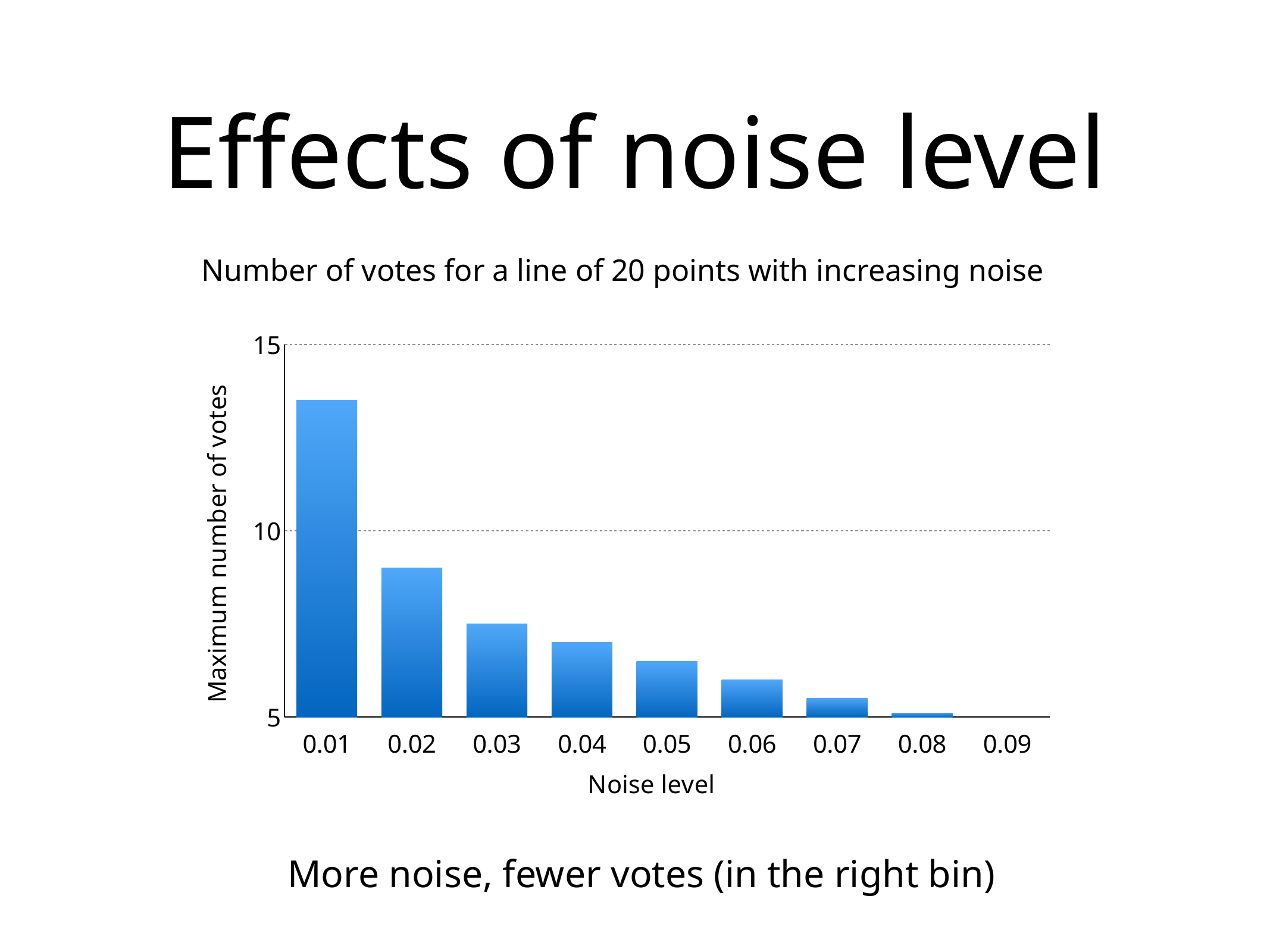
Do the values rise or fall as the noise level increases along the x axis? fall Which has a higher maximum number of votes, noise level 0.07 or noise level 0.03? 0.03 How many noise levels are shown on the x axis? 9 What is the label of the y axis? Maximum number of votes Which has a higher maximum number of votes, noise level 0.02 or noise level 0.06? 0.02 What kind of chart is shown on the slide? bar chart Is the value for noise level 0.05 greater or less than 10? less Is the value for noise level 0.02 greater or less than 10? less Is the value for noise level 0.01 greater or less than 15? less What is the title of the chart? Number of votes for a line of 20 points with increasing noise Which noise level has the highest maximum number of votes? 0.01